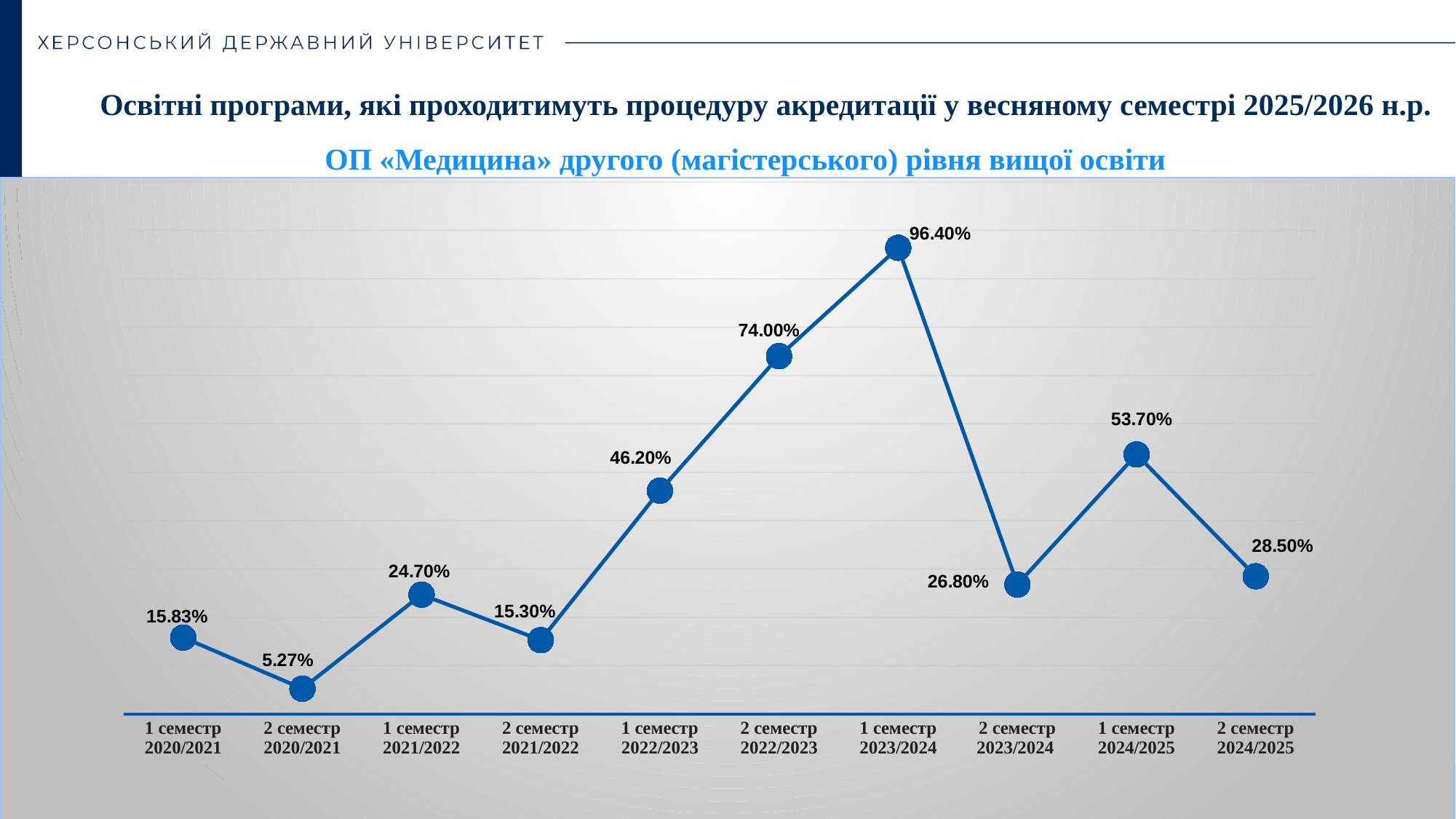
What is the value for 1 семестр 2023/2024? 96.40% What is the value for 2 семестр 2020/2021? 5.27% What is the value for 1 семестр 2024/2025? 53.70% Which is larger, the value for 2 семестр 2022/2023 or the value for 1 семестр 2024/2025? 2 семестр 2022/2023 Which semester has the lowest value? 2 семестр 2020/2021 How many data points are plotted on the chart? 10 What is the difference between the values for 1 семестр 2021/2022 and 2 семестр 2021/2022? 9.40% What is the difference between the values for 1 семестр 2023/2024 and 2 семестр 2023/2024? 69.60% Do the values rise or fall from 2 семестр 2021/2022 to 1 семестр 2023/2024? Rise What is the value for 2 семестр 2024/2025? 28.50% What kind of chart is shown on the slide? Line chart Which semester has the highest value? 1 семестр 2023/2024